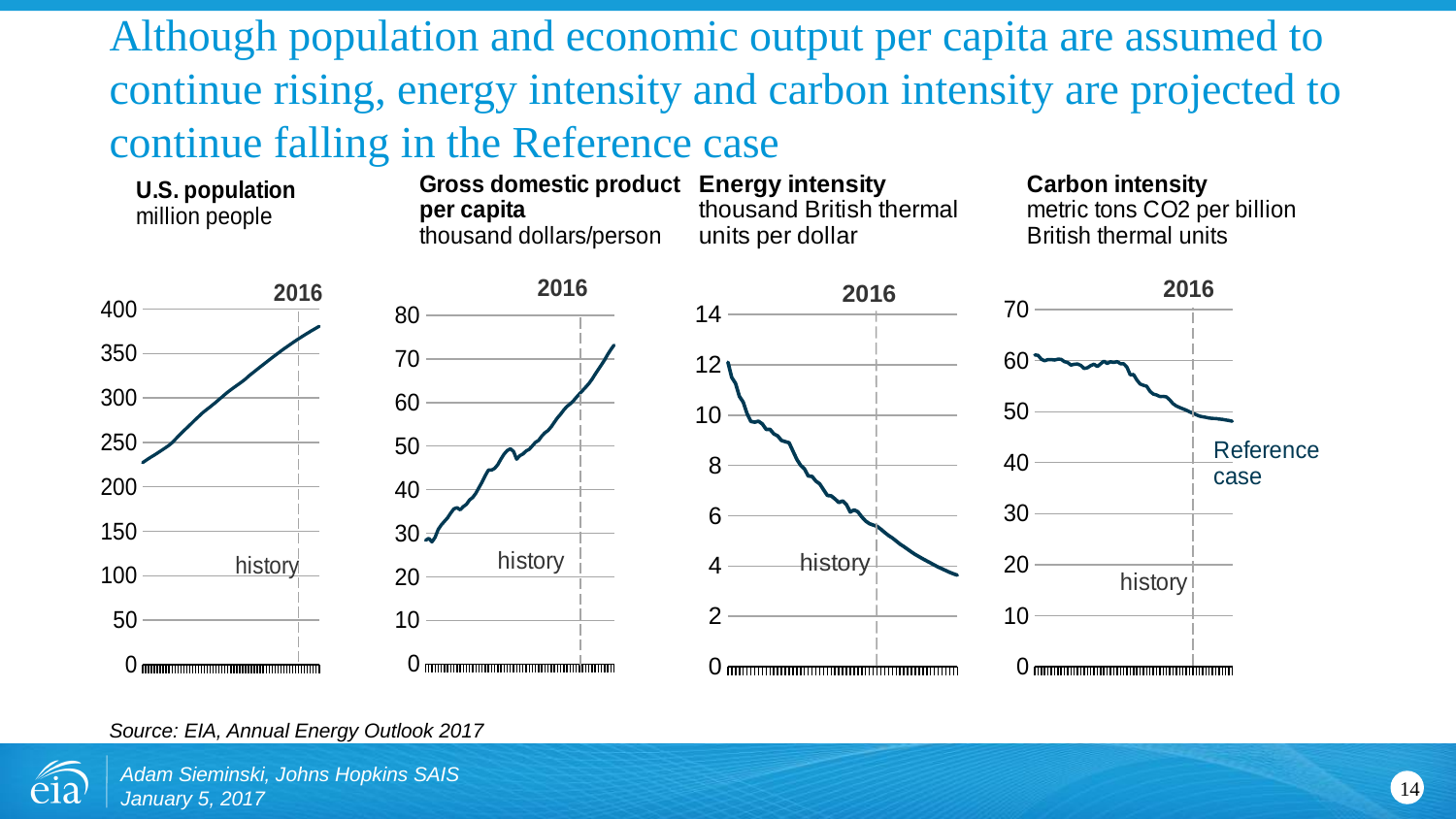
In the Carbon intensity chart, is the value at the end of the projection greater or less than 50? less In the Carbon intensity chart, do values rise or fall along the x axis? fall In the U.S. population chart, do values rise or fall along the x axis? rise What kind of chart is the U.S. population chart? line chart In the U.S. population chart, is the value at the start of the series greater or less than 250? less In the Energy intensity chart, is the value at the end of the projection greater or less than 4? less In the Gross domestic product per capita chart, do values rise or fall along the x axis? rise How many charts are shown on the slide? 4 What year does the vertical dashed line mark in each chart? 2016